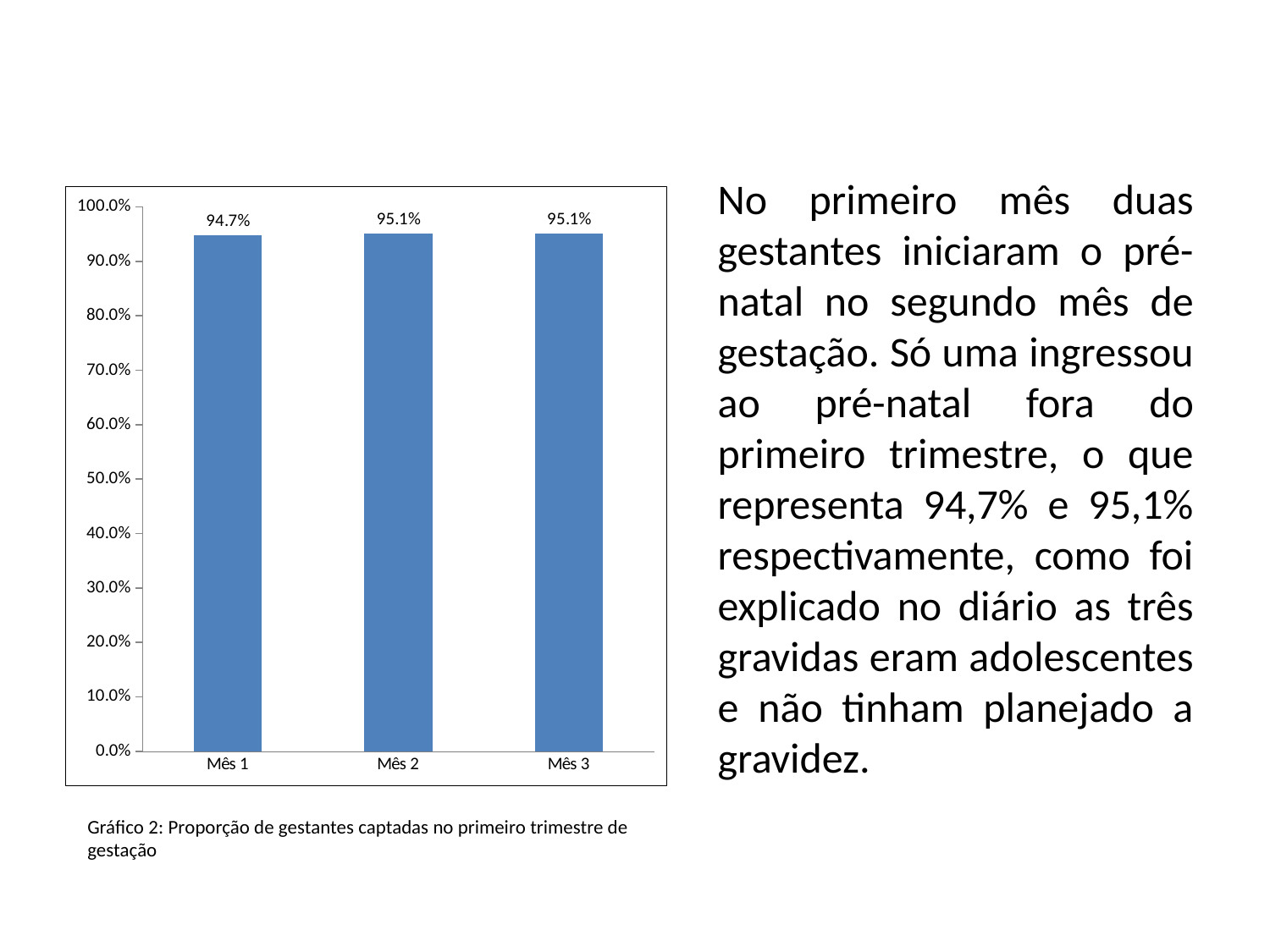
What kind of chart is shown on the slide? bar chart Which is larger, the value for Mês 1 or the value for Mês 2? Mês 2 What is the value for Mês 1? 94.7% Which month has the lowest value? Mês 1 What is the difference between the values for Mês 2 and Mês 1? 0.4% How many categories are shown on the x axis? 3 Do the values rise or fall from Mês 1 to Mês 2? rise Is the value for Mês 1 greater or less than 90.0%? greater What is the caption of the chart? Gráfico 2: Proporção de gestantes captadas no primeiro trimestre de gestação What is the value for Mês 2? 95.1% What is the highest value shown on the y axis? 100.0% What is the value for Mês 3? 95.1%